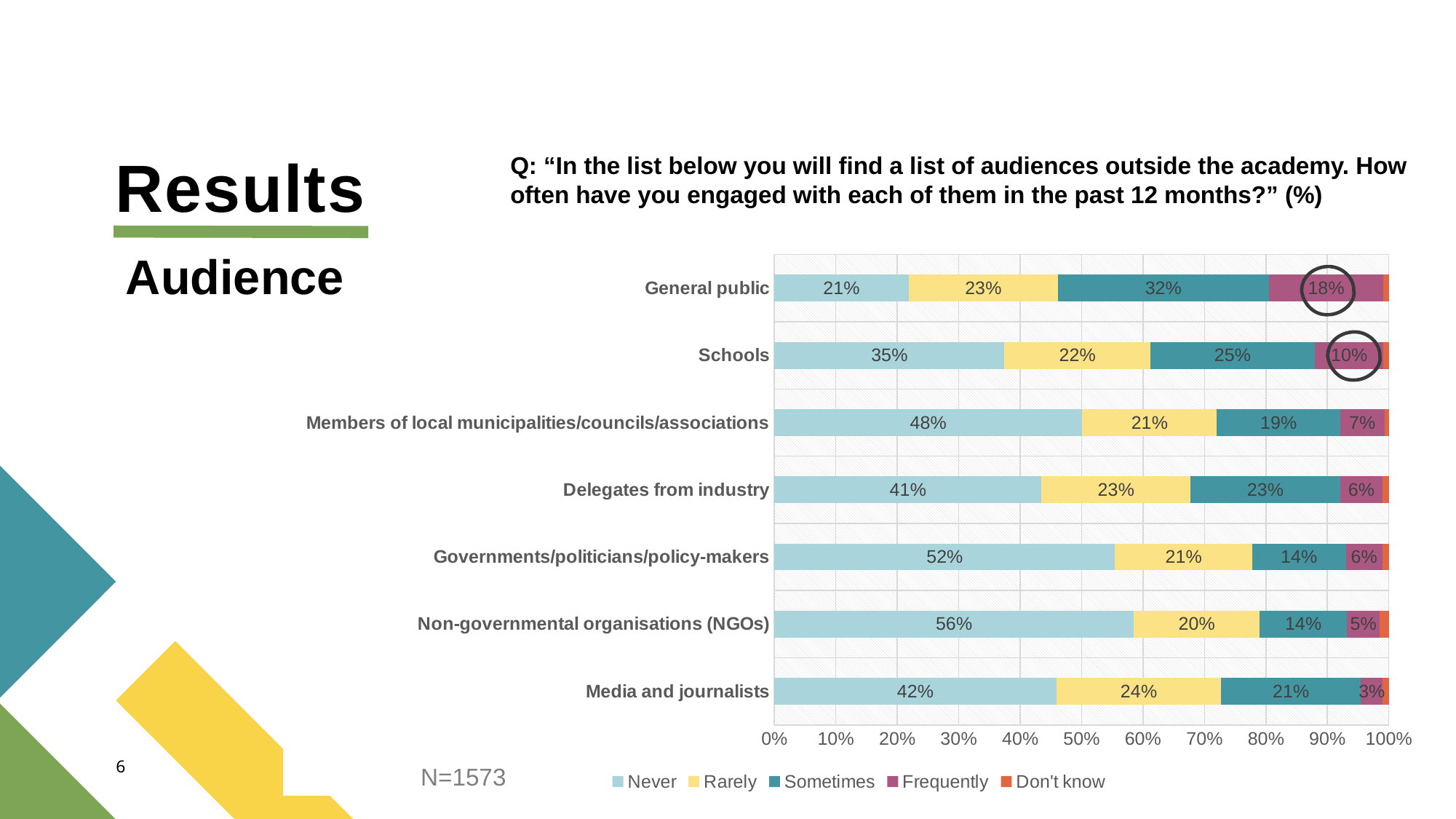
Which is larger: the "Sometimes" value for General public or the "Sometimes" value for Governments/politicians/policy-makers? General public Which audience has the lowest "Never" percentage? General public What percentage of respondents answered "Never" for Non-governmental organisations (NGOs)? 56% How many series does the legend list? 5 What is the difference in percentage points between the "Never" value for Governments/politicians/policy-makers and the "Never" value for Schools? 17 percentage points What kind of chart is shown on the slide? Stacked bar chart What is the "Sometimes" value for General public? 32% Which audience has the highest "Frequently" percentage? General public What is the "Rarely" value for Media and journalists? 24% What is the "Frequently" value for Schools? 10% How many audience categories are shown in the chart? 7 Which audience has the highest "Never" percentage? Non-governmental organisations (NGOs)